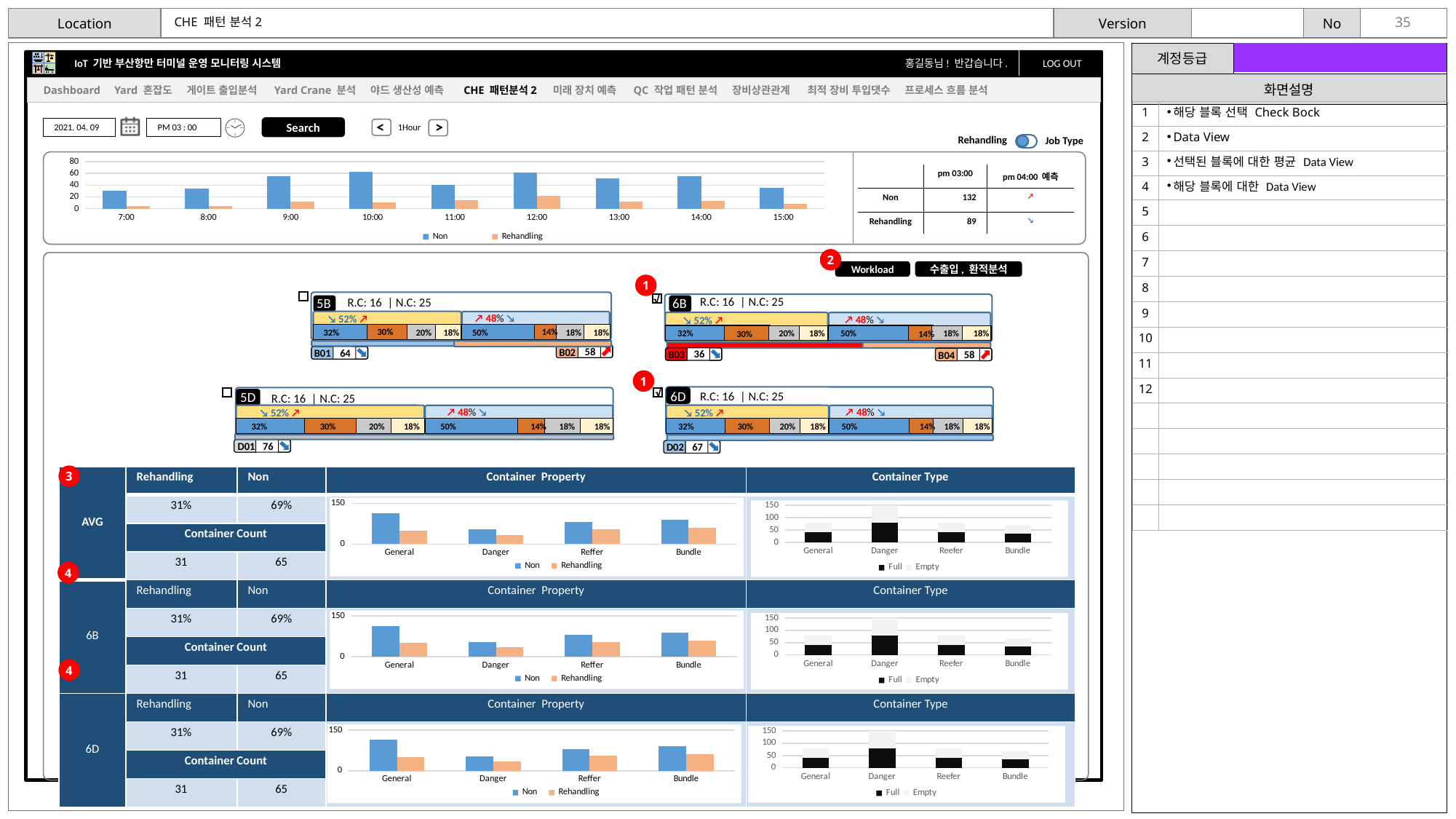
In the top hourly chart, which is larger: the Non value at 9:00 or the Non value at 11:00? Non at 9:00 How many time categories are shown on the x axis of the top hourly chart? 9 What kind of chart is the hourly chart at the top of the dashboard (7:00 to 15:00)? bar chart In the AVG row's Container Type chart, which category has the highest Full bar? Danger What are the two legend entries of the Container Type charts? Full, Empty In the AVG row's Container Property chart, how many categories are on the x axis? 4 In the top hourly chart, at which time is the Rehandling bar highest? 12:00 In the top hourly chart, is the Rehandling value at 7:00 greater or less than 20? less In the AVG row's Container Property chart, which category has the highest Non bar? General How many series does the legend of the top hourly chart list? 2 In the top hourly chart, is the Non value at 10:00 greater or less than 40? greater In the top hourly chart, which is larger at 12:00: Non or Rehandling? Non